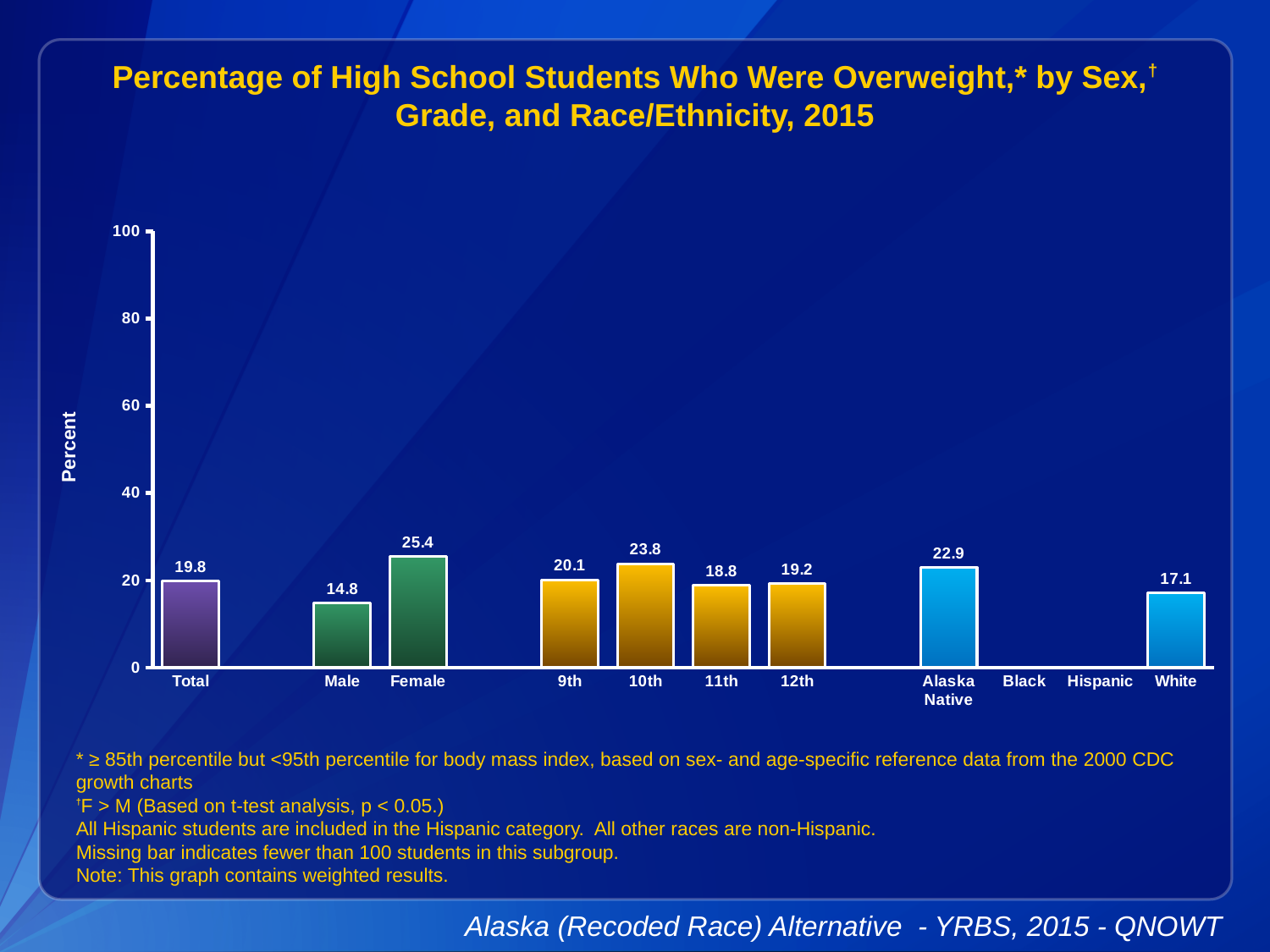
What is the value for Total? 19.8 What kind of chart is shown? bar chart What is the difference between the Female and Male values? 10.6 Is the value for White greater or less than 20? less How many bars are plotted on the chart? 9 Which category has the lowest value among the bars shown? Male What is the value for 10th grade? 23.8 What is the value for Alaska Native? 22.9 Which category has the highest value? Female Which is larger, the value for 11th grade or 12th grade? 12th What is the label of the y axis? Percent What is the value for Female? 25.4